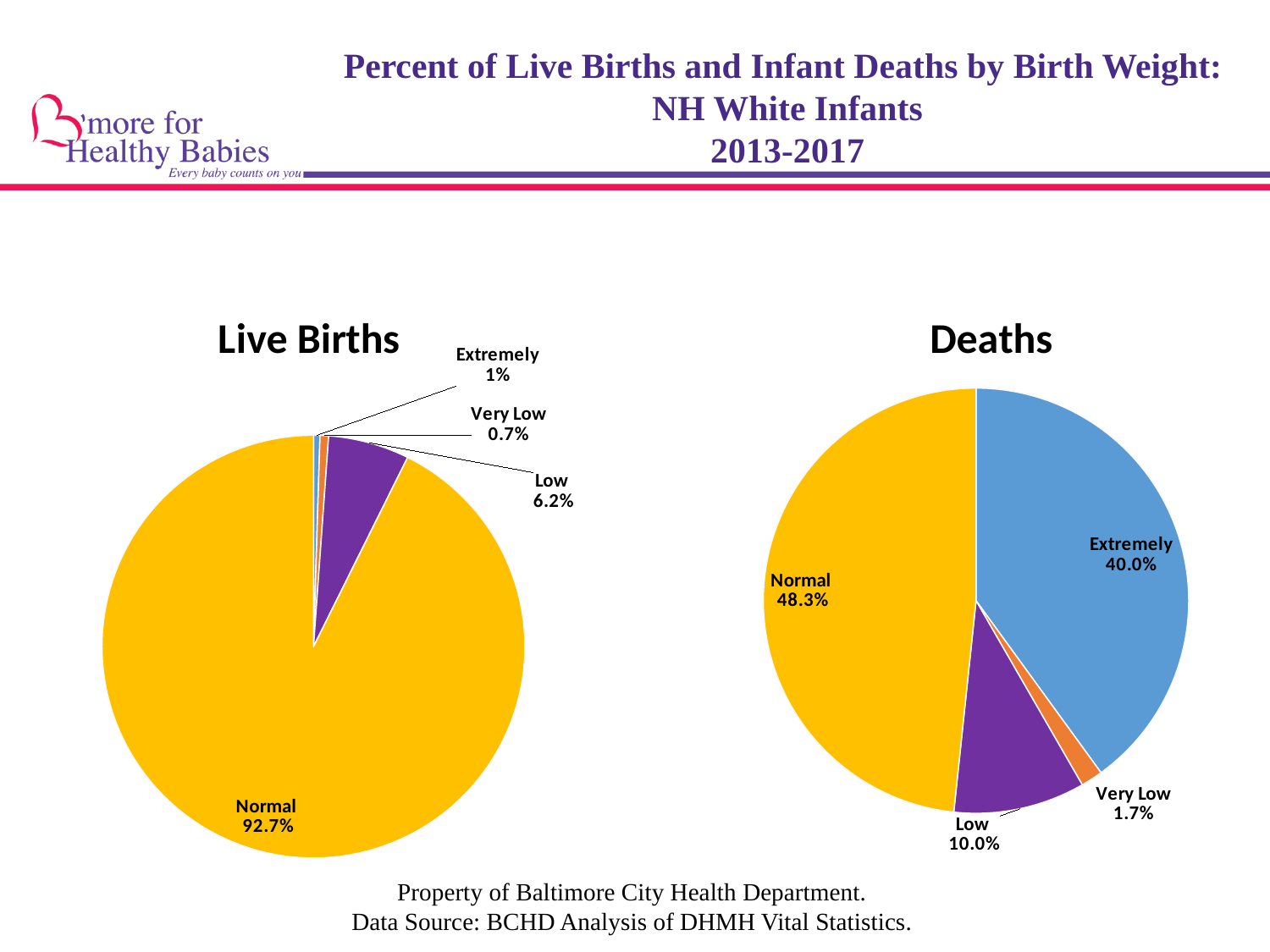
In the Deaths pie chart, what percentage is labelled for Low birth weight? 10.0% In the Deaths pie chart, which birth weight category has the largest share? Normal In the Live Births pie chart, what percentage is labelled for Normal birth weight? 92.7% In the Live Births pie chart, which is larger: the Low share or the Extremely share? Low What is the title of the chart on the right side of the slide? Deaths What type of chart is used for Live Births on this slide? Pie chart In the Deaths pie chart, what is the difference between the Normal and Extremely shares? 8.3% In the Deaths pie chart, what is the combined share of the Low and Very Low slices? 11.7% In the Live Births pie chart, what percentage is labelled for Very Low birth weight? 0.7% In the Deaths pie chart, what percentage is labelled for Extremely low birth weight? 40.0% How many slices does the Deaths pie chart have? 4